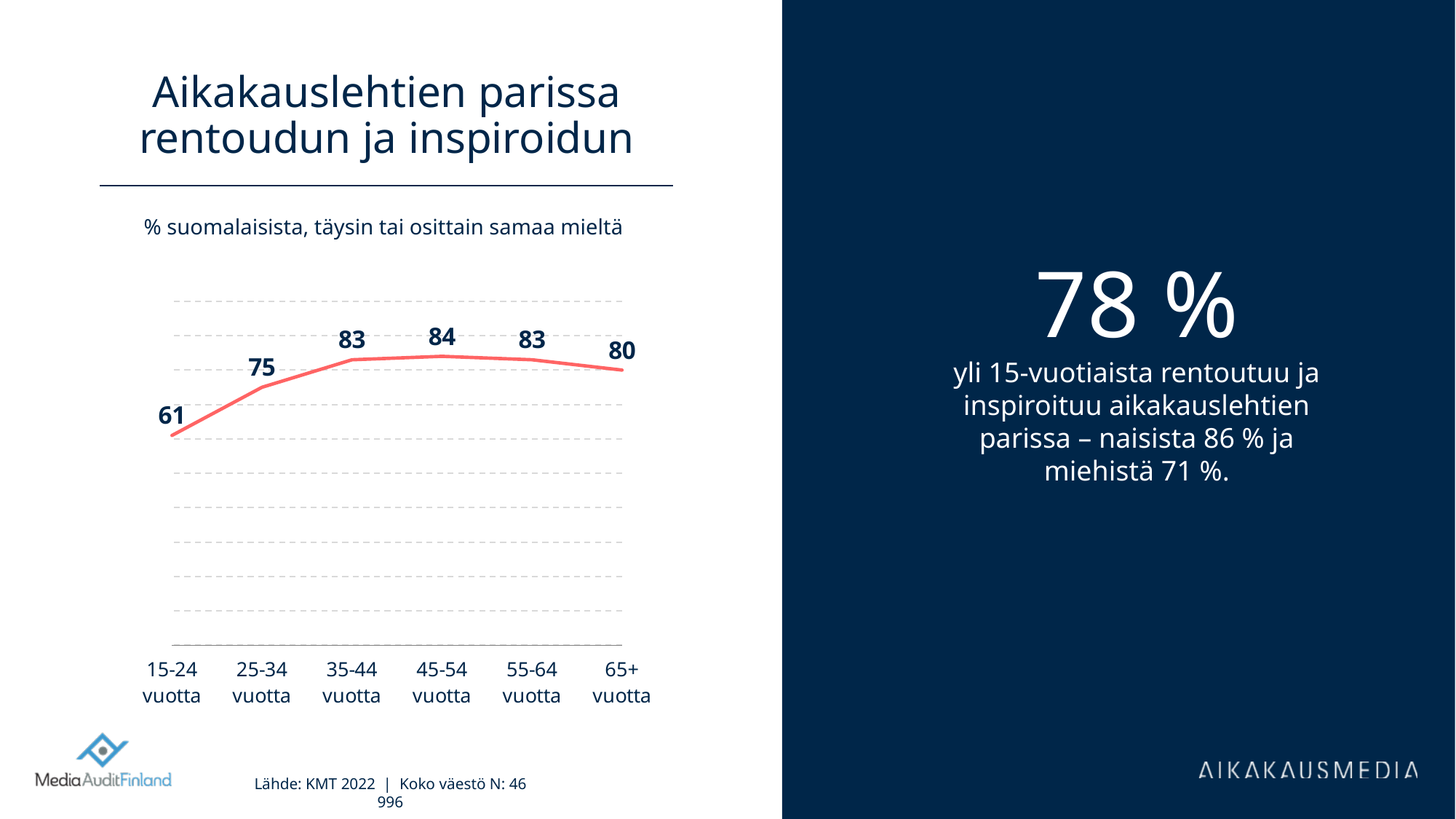
Which is larger, the value for 25-34 vuotta or the value for 65+ vuotta? 65+ vuotta Which age group has the lowest value? 15-24 vuotta What is the difference between the values for 25-34 vuotta and 15-24 vuotta? 14 What is the subtitle describing the chart's measure? % suomalaisista, täysin tai osittain samaa mieltä What is the value for the 65+ vuotta age group? 80 What kind of chart is shown on the slide? Line chart What is the value for the 15-24 vuotta age group? 61 What is the value for the 45-54 vuotta age group? 84 Which age group has the highest value? 45-54 vuotta Does the value rise or fall from 15-24 vuotta to 45-54 vuotta? Rise How many age groups are plotted on the chart? 6 What colour is the line in the chart? Red